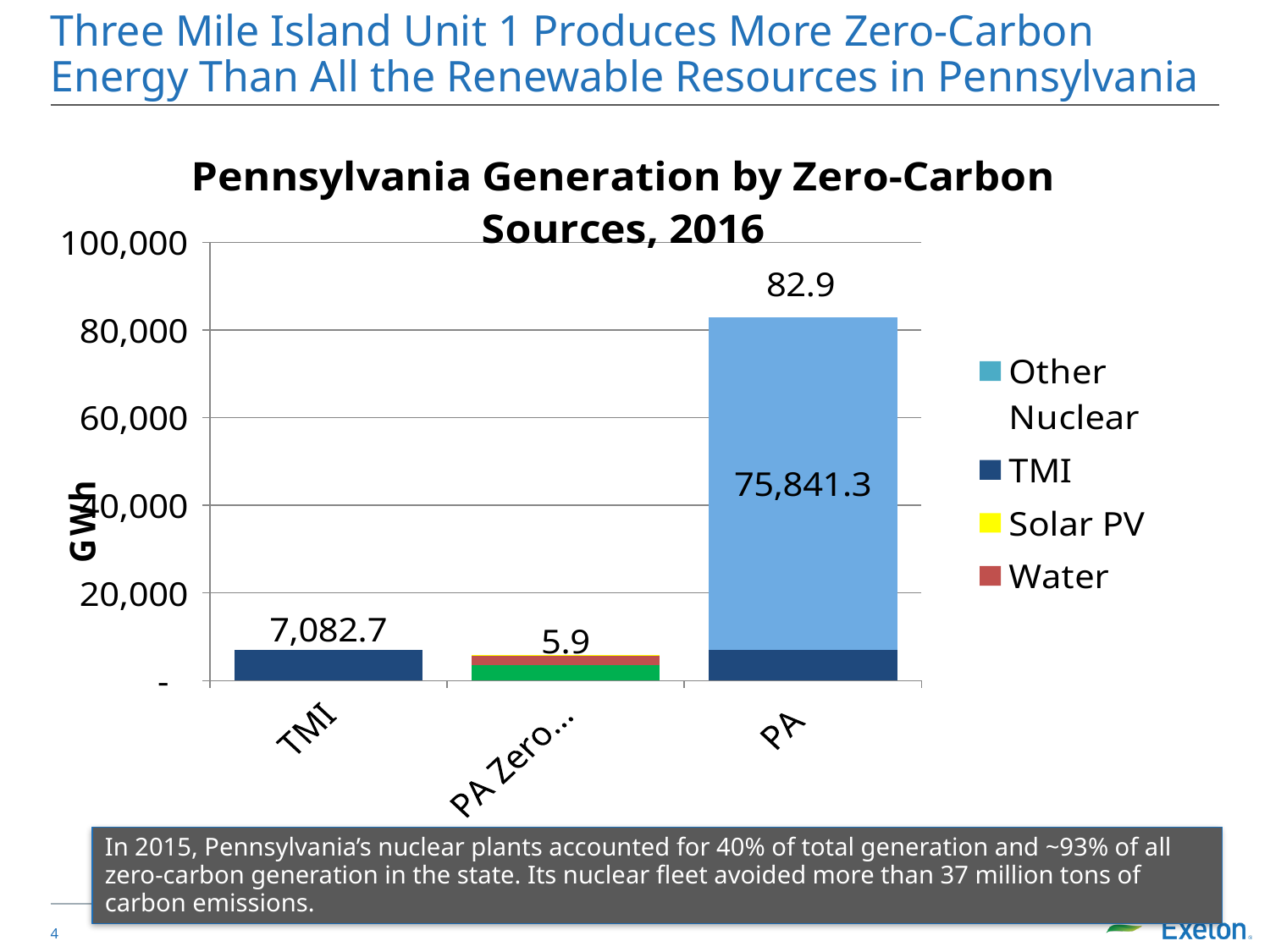
Which bar is taller, TMI or PA? PA Is the value for TMI greater or less than 20,000? less What is the title of the chart? Pennsylvania Generation by Zero-Carbon Sources, 2016 What kind of chart is shown on the slide? bar chart What is the value labelled for Other Nuclear in the PA bar? 75,841.3 What is the value labelled on the TMI bar? 7,082.7 What is the difference between the Other Nuclear value in the PA bar (75,841.3) and the TMI bar value (7,082.7)? 68,758.6 Which category has the tallest bar? PA Is the total of the PA bar greater or less than 60,000? greater What unit is shown on the y-axis label? GWh How many categories are shown on the x axis? 3 How many series does the chart legend list? 4